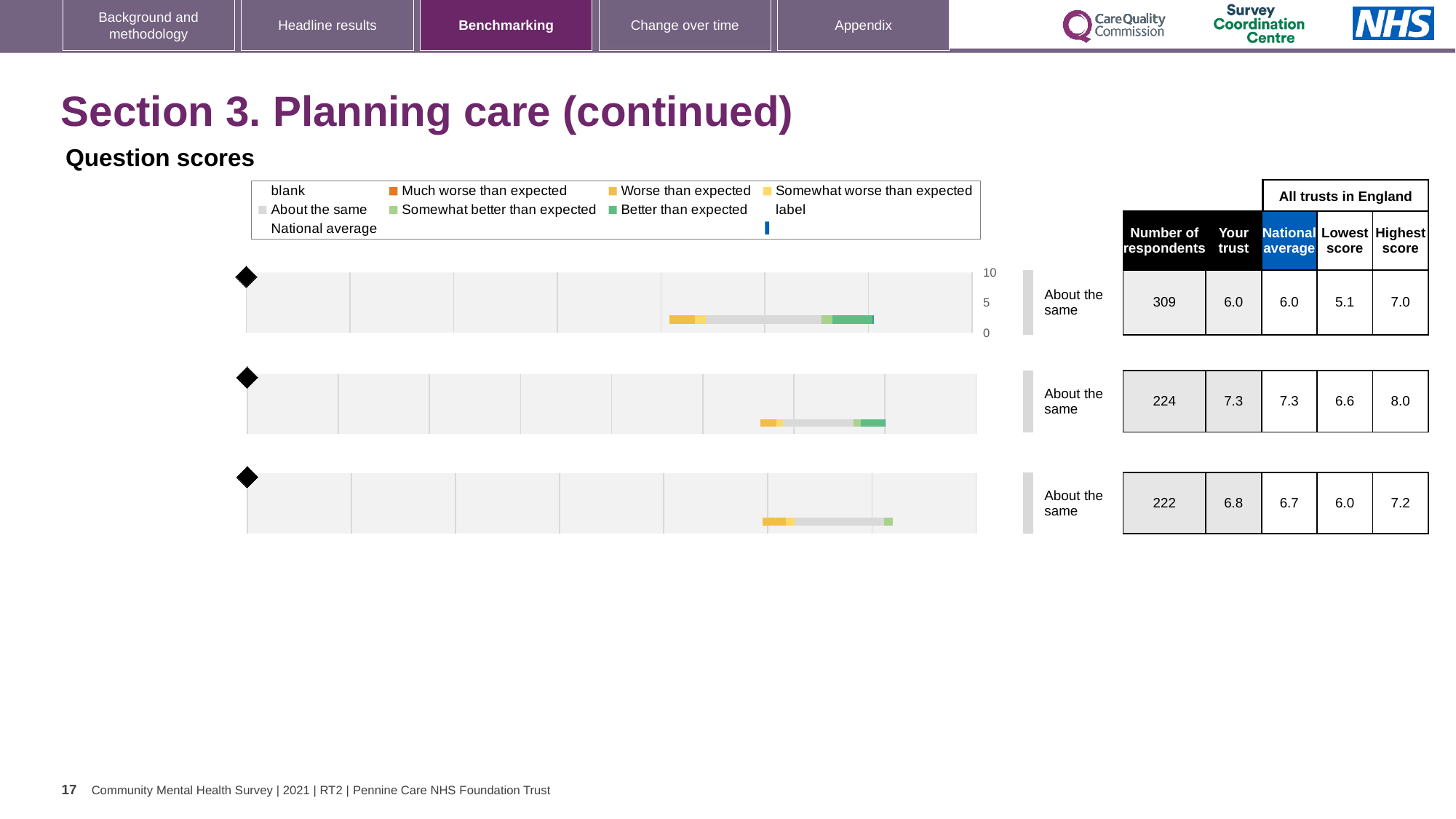
For the bottom chart row, what is the lowest score among all trusts in England? 6.0 Which legend entry is shown in orange? Much worse than expected For the middle chart row, what is the national average score? 7.3 What benchmark category is shown next to the bottom chart row? About the same For the middle chart row, what is the highest score among all trusts in England? 8.0 For the top chart row, what is the 'Your trust' score? 6.0 What kind of chart is used for the three question-score rows on the slide? bar chart For the top chart row, what is the number of respondents? 309 What is the highest axis tick value shown on the top chart? 10 How many question-score charts are shown on the slide? 3 Which chart row has the highest 'Your trust' score: top, middle or bottom? middle For the bottom chart row, what is the difference between the 'Your trust' score and the national average? 0.1